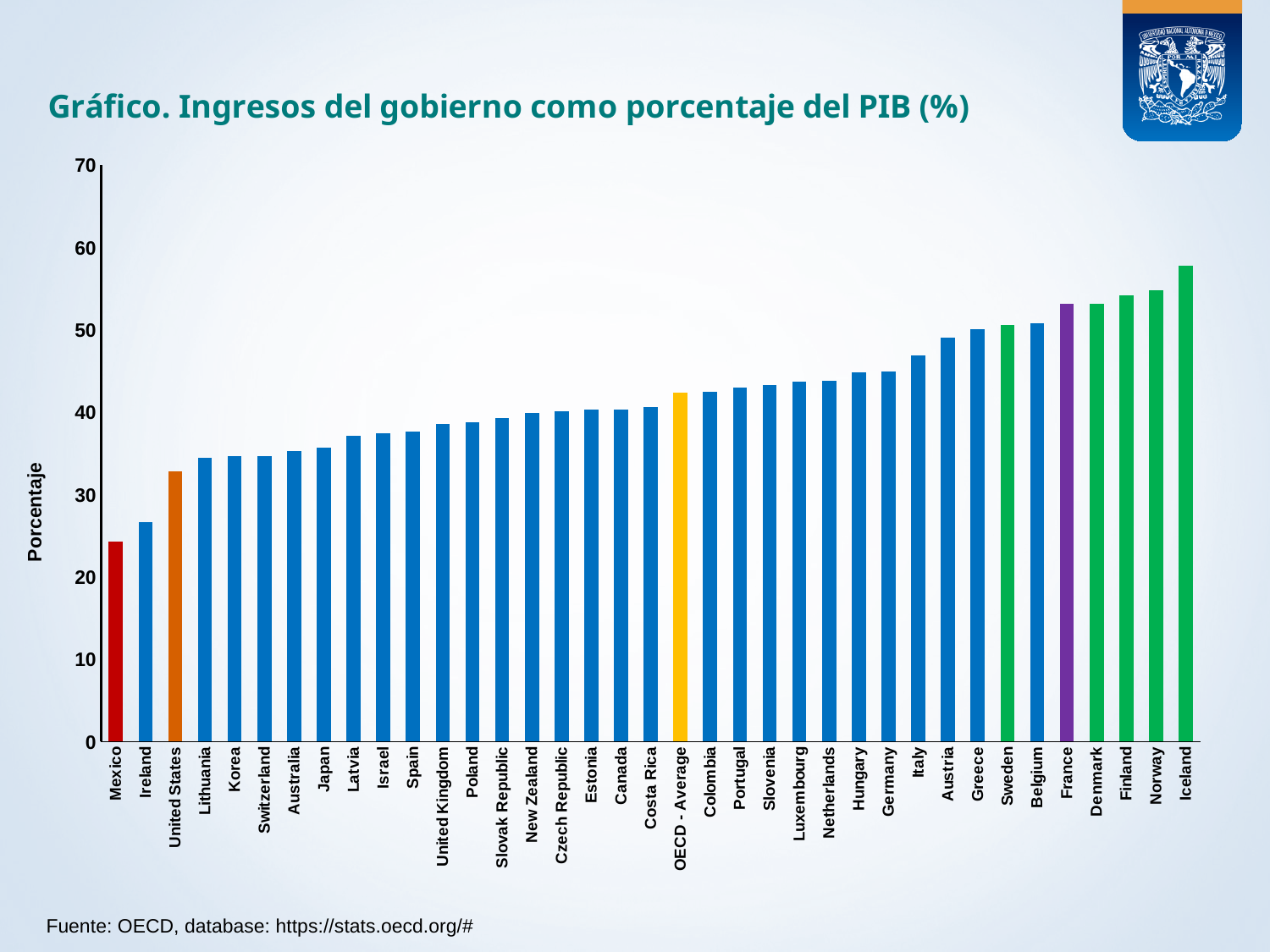
Is the value for Mexico greater or less than 30? less Is the value for United States greater or less than 30? greater Which country has the lowest government revenue as a percentage of GDP? Mexico What is the title of the chart? Gráfico. Ingresos del gobierno como porcentaje del PIB (%) Which country has the highest government revenue as a percentage of GDP? Iceland Is the value for OECD - Average greater or less than 40? greater Do the values rise or fall moving from left to right along the x axis? rise Which has a higher value, Ireland or United States? United States What kind of chart is shown on the slide? bar chart How many bars are plotted in the chart? 37